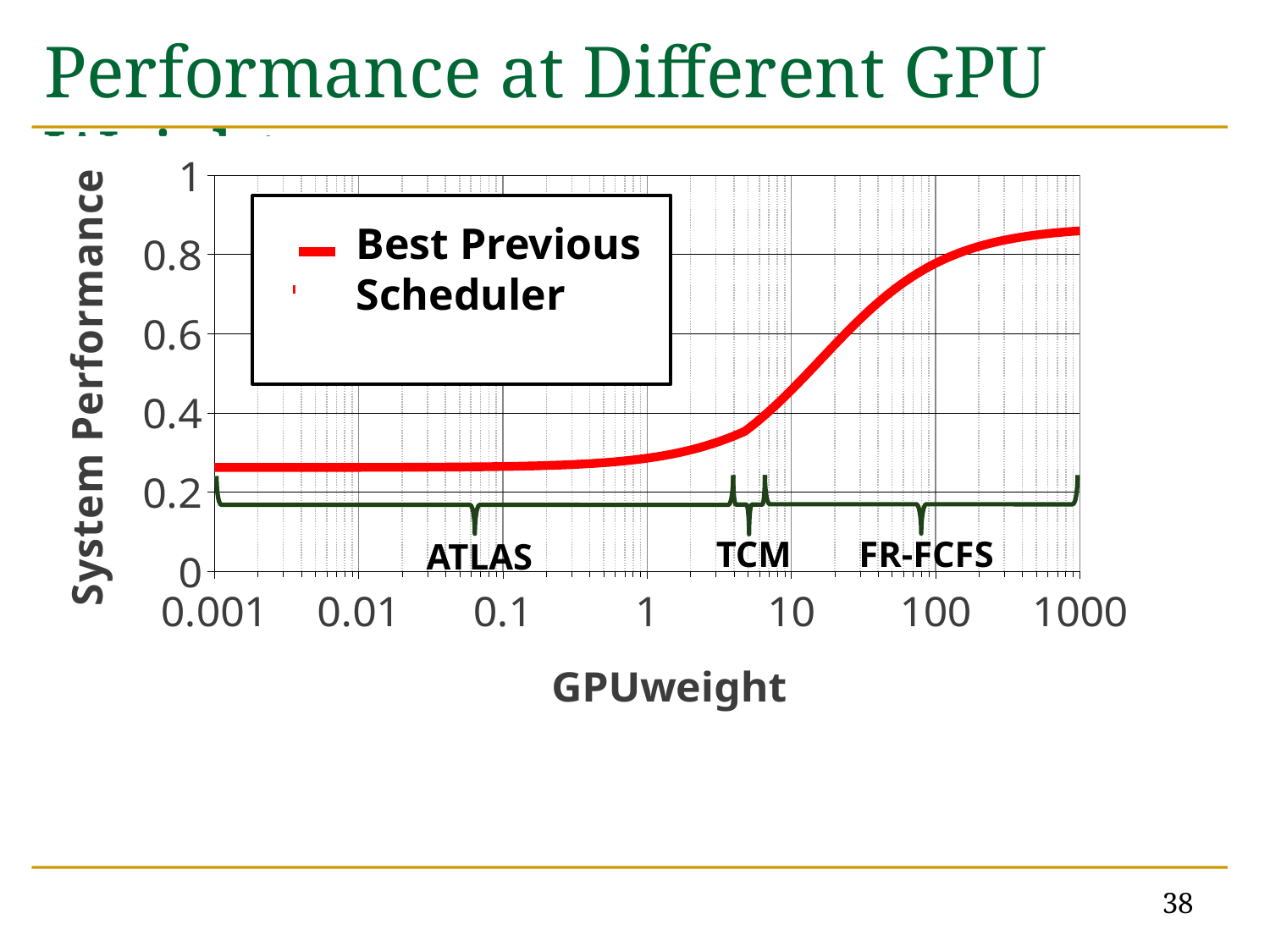
At which end of the GPUweight axis is the System Performance of the Best Previous Scheduler lowest, 0.001 or 1000? 0.001 Is the System Performance of the Best Previous Scheduler at GPUweight 0.001 greater or less than 0.2? greater Is the System Performance of the Best Previous Scheduler at GPUweight 1000 greater or less than 0.8? greater What kind of chart is shown on the slide? line chart Is the System Performance of the Best Previous Scheduler at GPUweight 0.001 greater or less than 0.4? less How many series does the legend list? 1 What is the label of the x axis? GPUweight Does the System Performance of the Best Previous Scheduler rise or fall as GPUweight increases? rise Which is larger, the System Performance of the Best Previous Scheduler at GPUweight 1000 or at GPUweight 0.01? at GPUweight 1000 What is the name of the series shown in the legend? Best Previous Scheduler